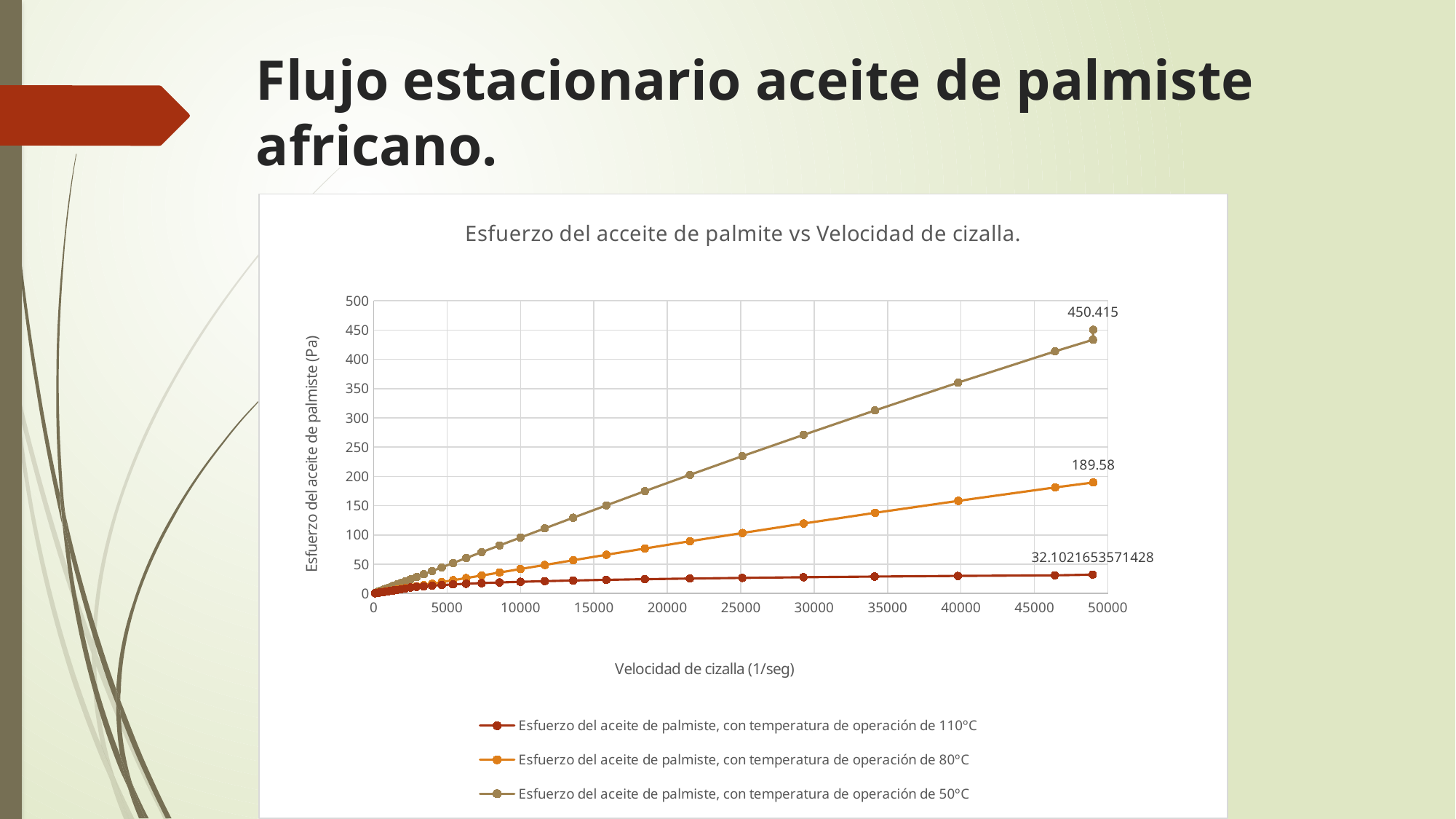
What is the difference between the final labelled values of the 50°C series and the 80°C series? 260.835 Which series has the lowest stress values across the chart? Esfuerzo del aceite de palmiste, con temperatura de operación de 110°C What is the final data label for the series with operating temperature of 110°C? 32.1021653571428 Is the value for the 110°C series at a shear rate of 40000 greater or less than 50? less Which series reaches the highest stress value at the end of the x axis? Esfuerzo del aceite de palmiste, con temperatura de operación de 50°C What kind of chart is shown on the slide? line chart What is the final data label for the series with operating temperature of 80°C? 189.58 Is the value for the 50°C series at a shear rate of 45000 greater or less than 400? greater What is the title of the chart? Esfuerzo del acceite de palmite vs Velocidad de cizalla. How many series does the legend list? 3 Do the stress values rise or fall as shear rate increases along the x axis? rise What is the final data label for the series with operating temperature of 50°C? 450.415